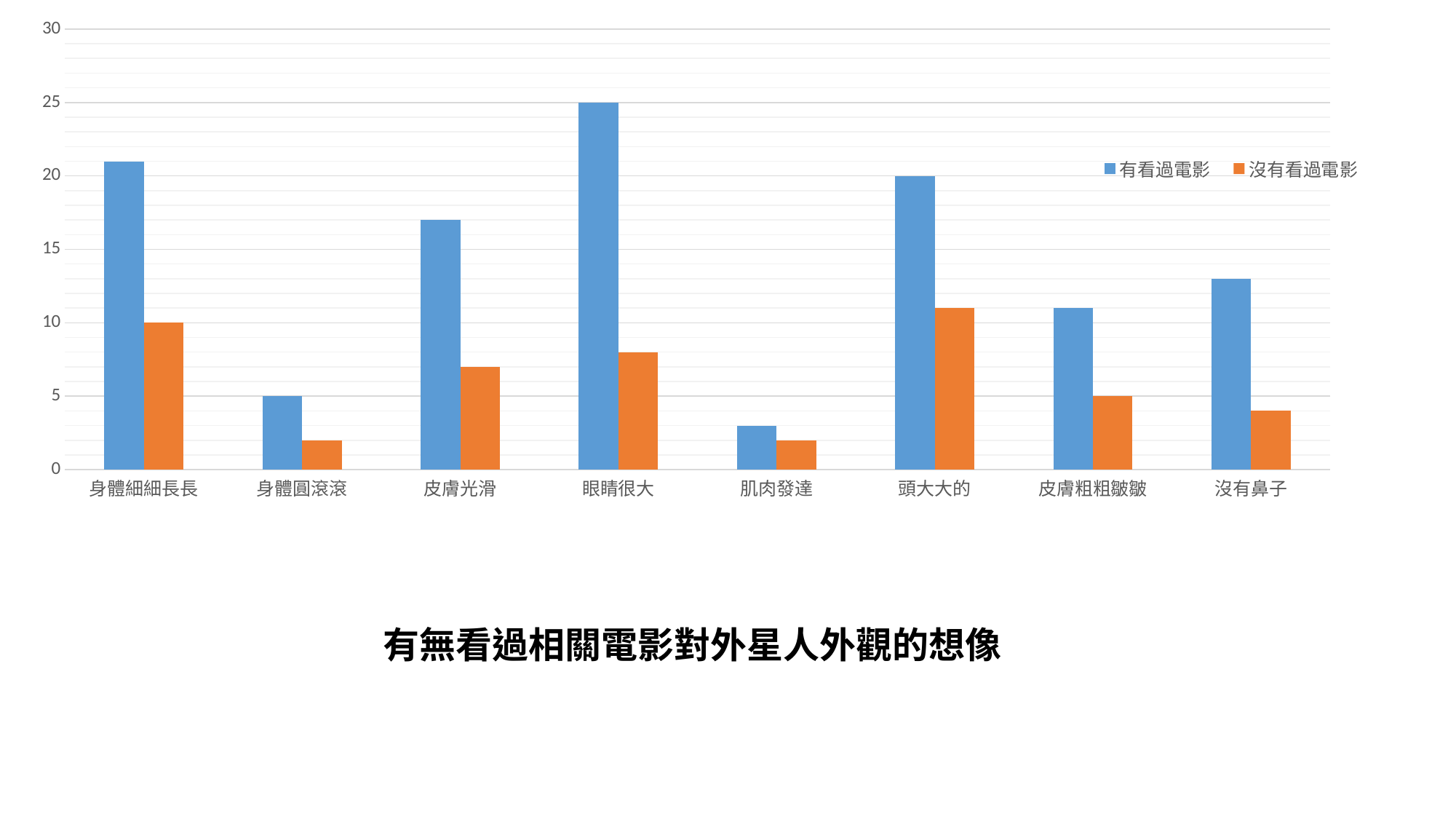
What is the value of 有看過電影 for 眼睛很大? 25 Which is larger for 沒有鼻子: 有看過電影 or 沒有看過電影? 有看過電影 What is the value of 有看過電影 for 頭大大的? 20 How many series does the legend list? 2 Which category has the lowest 有看過電影 value? 肌肉發達 Is the 有看過電影 value for 皮膚光滑 greater or less than 15? greater How many categories are shown on the x axis? 8 What is the value of 沒有看過電影 for 身體細細長長? 10 Which category has the highest 沒有看過電影 value? 頭大大的 What kind of chart is shown on the slide? bar chart What is the title shown below the chart? 有無看過相關電影對外星人外觀的想像 Which category has the highest 有看過電影 value? 眼睛很大